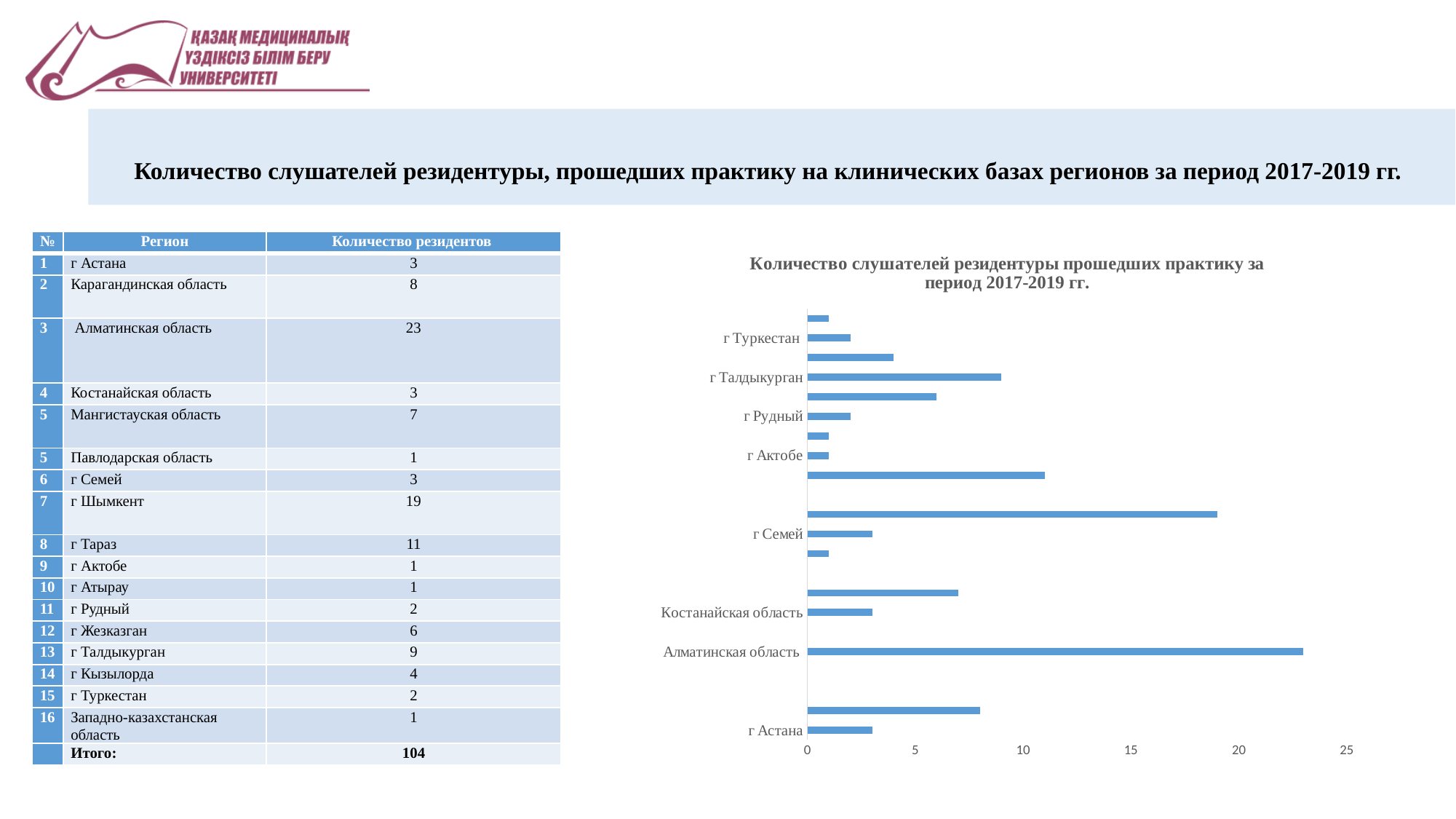
What is the difference between the values for Алматинская область and г Талдыкурган? 14 How many residents does the slide report for г Талдыкурган? 9 What is the title of the chart? Количество слушателей резидентуры прошедших практику за период 2017-2019 гг. What kind of chart is shown on the slide? bar chart Is the value for Алматинская область greater or less than 20? greater What is the highest value shown on the chart's horizontal axis? 25 Which region has the longest bar in the chart? Алматинская область Which is larger, the value for г Талдыкурган or the value for г Актобе? г Талдыкурган Which is larger, the value for Алматинская область or the value for г Астана? Алматинская область How many residents does the slide report for Алматинская область? 23 Is the value for г Астана greater or less than 5? less Is the value for г Талдыкурган greater or less than 10? less